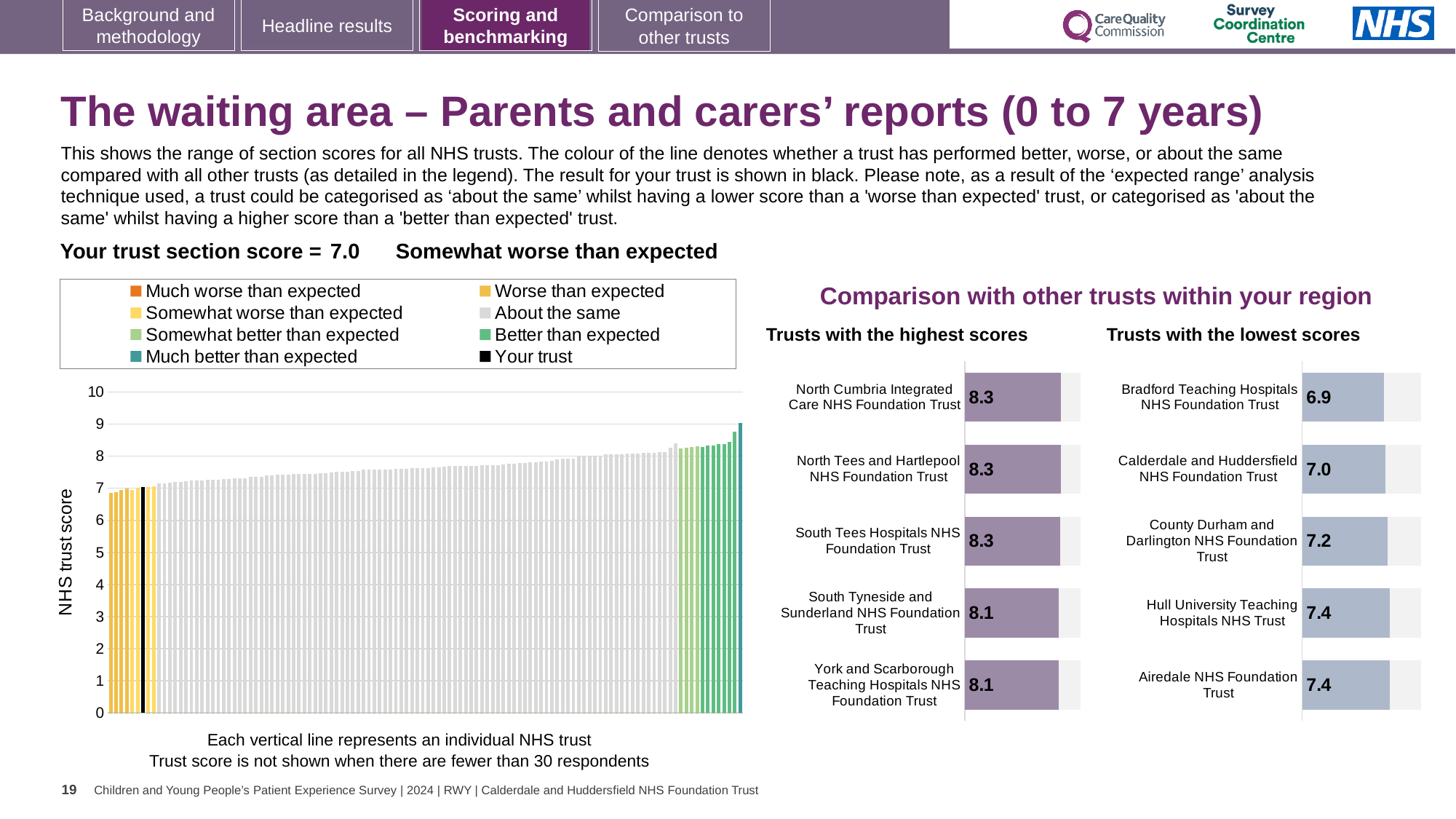
How many trusts are listed in the 'Trusts with the highest scores' chart? 5 What kind of chart is the large chart on the left showing all NHS trusts? bar chart In the 'Trusts with the highest scores' chart, what is the score for South Tyneside and Sunderland NHS Foundation Trust? 8.1 In the 'Trusts with the lowest scores' chart, what is the score for Bradford Teaching Hospitals NHS Foundation Trust? 6.9 In the large chart on the left showing all NHS trusts, is the value of the tallest bar greater or less than 8? greater In the 'Trusts with the lowest scores' chart, which has the higher score: County Durham and Darlington NHS Foundation Trust or Calderdale and Huddersfield NHS Foundation Trust? County Durham and Darlington NHS Foundation Trust In the 'Trusts with the highest scores' chart, what is the difference between the scores of North Cumbria Integrated Care NHS Foundation Trust and York and Scarborough Teaching Hospitals NHS Foundation Trust? 0.2 In the 'Trusts with the lowest scores' chart, what is the score for Hull University Teaching Hospitals NHS Trust? 7.4 In the large chart on the left showing all NHS trusts, do the bar values rise or fall from left to right? rise In the 'Trusts with the lowest scores' chart, which trust has the lowest score? Bradford Teaching Hospitals NHS Foundation Trust In the 'Trusts with the lowest scores' chart, what is the difference between the scores of Airedale NHS Foundation Trust and Bradford Teaching Hospitals NHS Foundation Trust? 0.5 How many entries does the legend of the large chart on the left list? 8